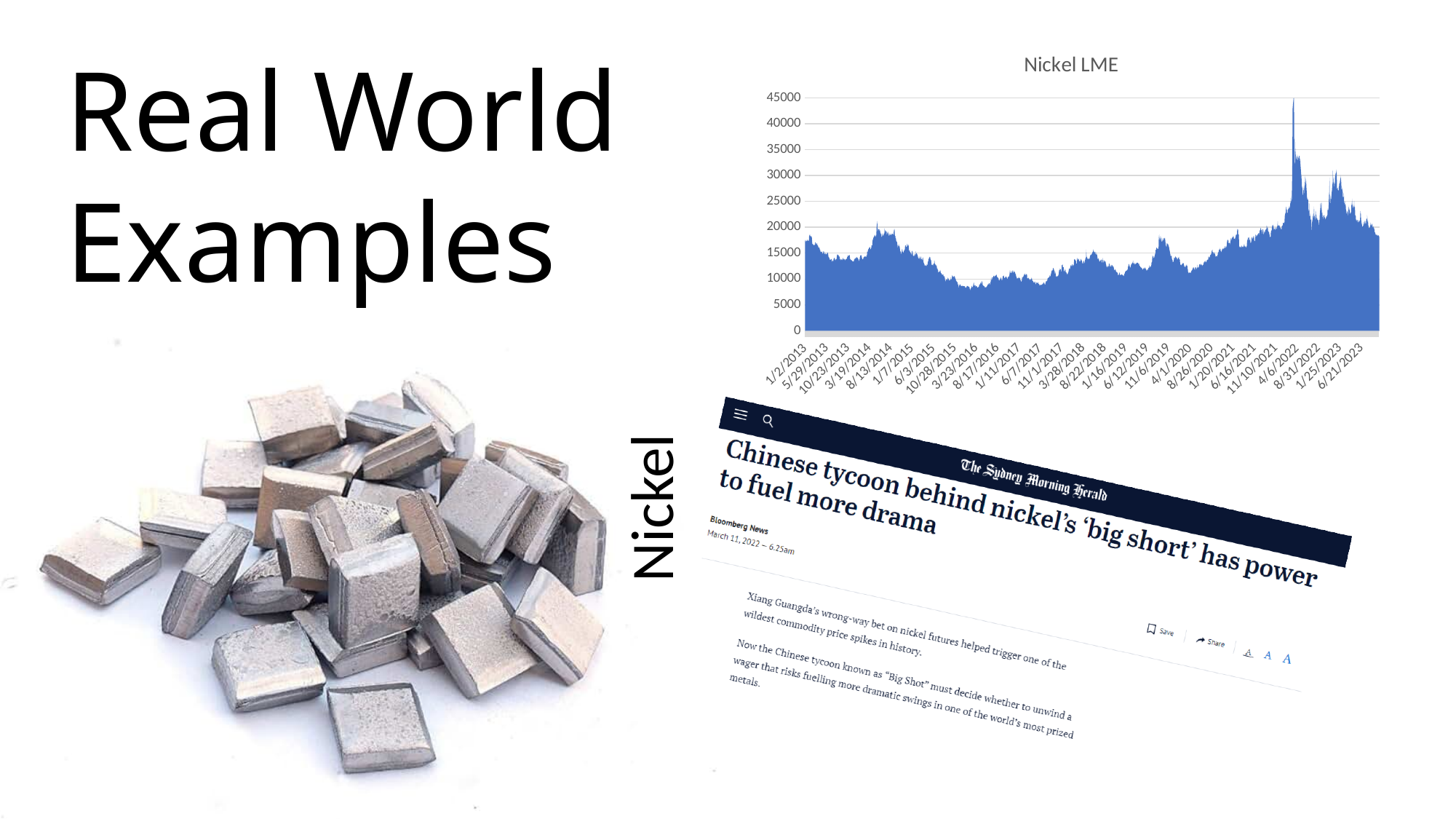
What is the highest value shown on the y axis of the Nickel LME chart? 45000 What is the title of the chart on the slide? Nickel LME In the Nickel LME chart, is the value around 1/11/2017 greater or less than 15000? less In the Nickel LME chart, is the value around 8/13/2014 greater or less than 15000? greater In the Nickel LME chart, do values generally rise or fall between 1/2/2013 and 3/23/2016? fall Around which x-axis date does the Nickel LME chart reach its highest value? 4/6/2022 In the Nickel LME chart, is the value around 3/23/2016 greater or less than 10000? less In the Nickel LME chart, do values generally rise or fall between 4/1/2020 and 4/6/2022? rise What kind of chart is the Nickel LME chart? area chart